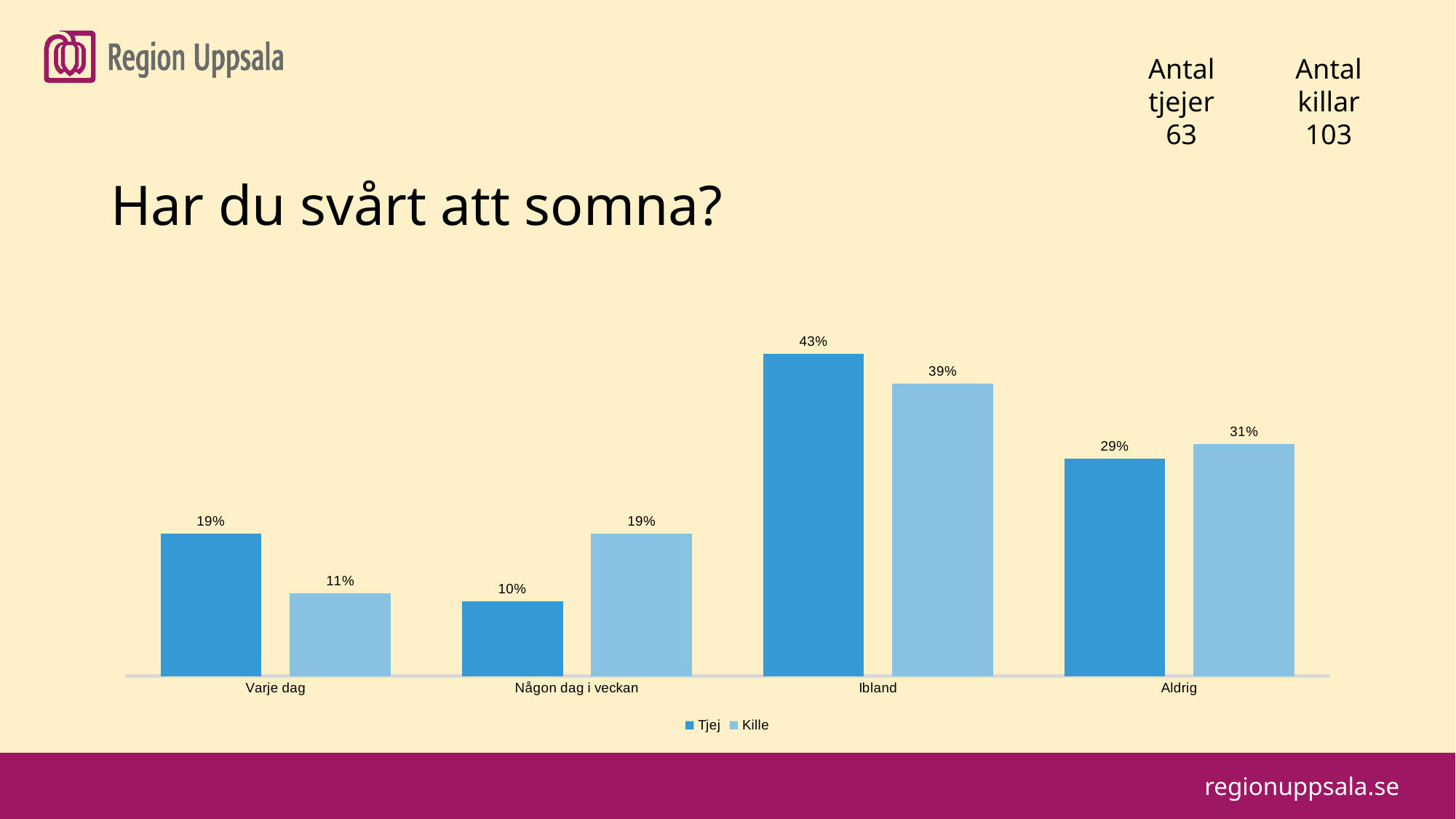
What is the title of the chart? Har du svårt att somna? What is the difference between the Tjej and Kille values in the Ibland category? 4% How many series does the legend list? 2 Which category has the lowest value for Tjej? Någon dag i veckan How many categories are shown on the x axis? 4 What is the value for Kille in the Varje dag category? 11% What is the value for Tjej in the Någon dag i veckan category? 10% In the Någon dag i veckan category, which series has the larger value, Tjej or Kille? Kille What is the value for Kille in the Aldrig category? 31% What is the value for Tjej in the Ibland category? 43% Which category has the highest value for Kille? Ibland What kind of chart is shown on the slide? Bar chart